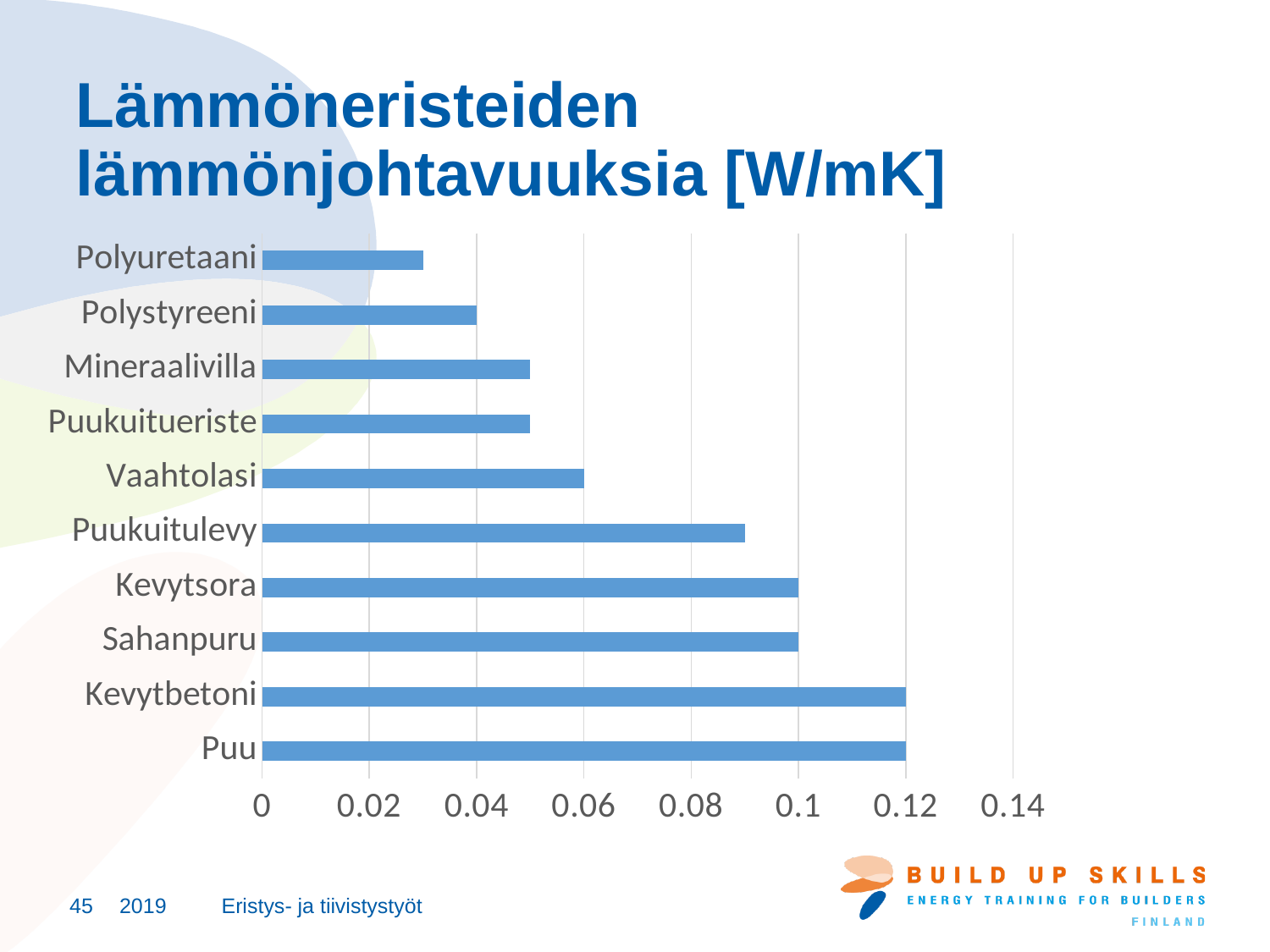
Is the value for Puukuitulevy greater or less than 0.1? less What is the difference between the values for Puu and Polystyreeni? 0.08 Which has a larger value, Vaahtolasi or Polystyreeni? Vaahtolasi Is the value for Polyuretaani greater or less than 0.02? greater What is the value for Kevytbetoni? 0.12 What is the value for Puu? 0.12 What is the value for Kevytsora? 0.1 What kind of chart is shown on the slide? bar chart Which material has the lowest thermal conductivity value in the chart? Polyuretaani What is the value for Polystyreeni? 0.04 How many materials (categories) are plotted in the chart? 10 What is the value for Vaahtolasi? 0.06